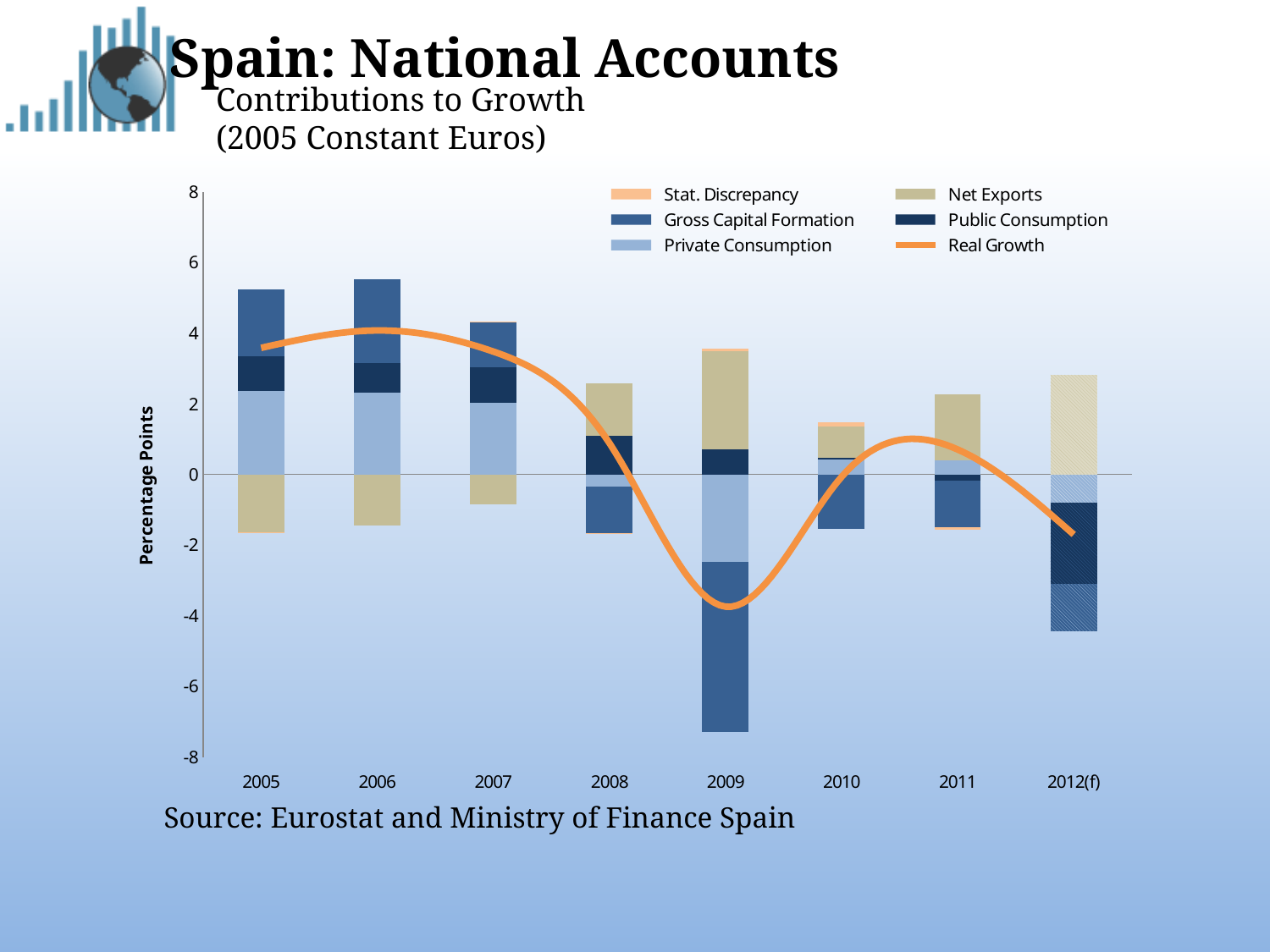
Is the Net Exports contribution for 2005 greater or less than 0? less What is the label on the vertical axis of the chart? Percentage Points In which year is the Real Growth line at its lowest point? 2009 How many series does the chart's legend list? 6 Is the Gross Capital Formation contribution for 2009 greater or less than -4? less How many years are shown on the x axis of the chart? 8 Is the Real Growth value for 2009 greater or less than -2? less Does the Real Growth line rise or fall between 2006 and 2009? fall In which year does the Real Growth line reach its highest point? 2006 What kind of chart is shown on the slide? combination bar and line chart